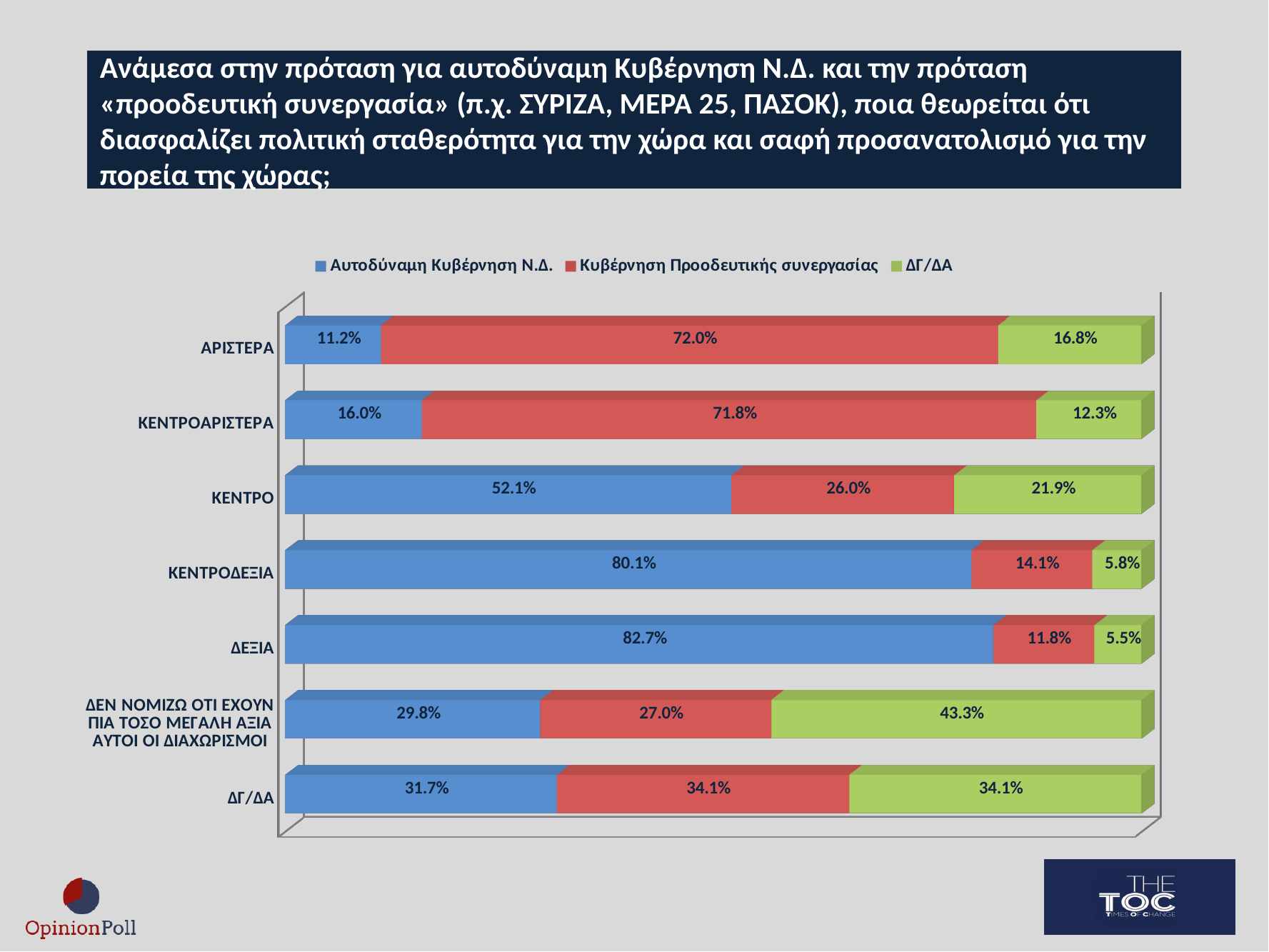
What type of chart is shown on the slide? Stacked bar chart What is the value for Αυτοδύναμη Κυβέρνηση Ν.Δ. in the ΚΕΝΤΡΟ category? 52.1% What is the ΔΓ/ΔΑ value for the category ΔΕΝ ΝΟΜΙΖΩ ΟΤΙ ΕΧΟΥΝ ΠΙΑ ΤΟΣΟ ΜΕΓΑΛΗ ΑΞΙΑ ΑΥΤΟΙ ΟΙ ΔΙΑΧΩΡΙΣΜΟΙ? 43.3% Which category has the highest ΔΓ/ΔΑ value? ΔΕΝ ΝΟΜΙΖΩ ΟΤΙ ΕΧΟΥΝ ΠΙΑ ΤΟΣΟ ΜΕΓΑΛΗ ΑΞΙΑ ΑΥΤΟΙ ΟΙ ΔΙΑΧΩΡΙΣΜΟΙ In the ΚΕΝΤΡΟ category, what is the difference between the Αυτοδύναμη Κυβέρνηση Ν.Δ. value and the Κυβέρνηση Προοδευτικής συνεργασίας value? 26.1 percentage points How many series does the legend list? 3 What colour represents the ΔΓ/ΔΑ series in the chart? Green Which category has the highest value for Αυτοδύναμη Κυβέρνηση Ν.Δ.? ΔΕΞΙΑ What is the value for Κυβέρνηση Προοδευτικής συνεργασίας in the ΑΡΙΣΤΕΡΑ category? 72.0% In the ΚΕΝΤΡΟΔΕΞΙΑ category, which is larger: the Κυβέρνηση Προοδευτικής συνεργασίας value or the ΔΓ/ΔΑ value? Κυβέρνηση Προοδευτικής συνεργασίας How many categories are shown on the chart? 7 Which category has the lowest value for Αυτοδύναμη Κυβέρνηση Ν.Δ.? ΑΡΙΣΤΕΡΑ